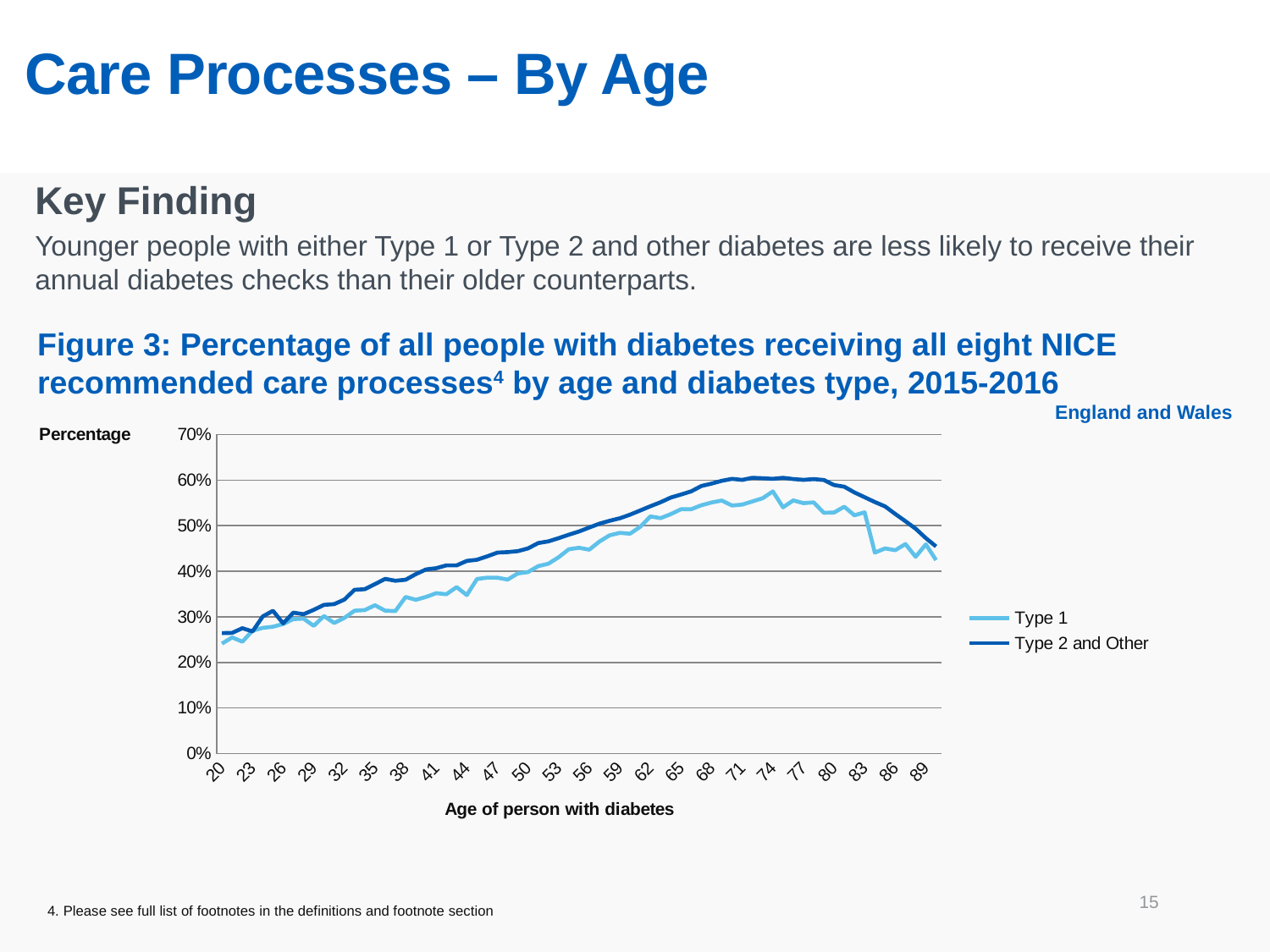
How many series does the legend list? 2 Is the Type 2 and Other value at age 89 greater or less than 50%? less At age 83, which series has the higher value, Type 1 or Type 2 and Other? Type 2 and Other At age 50, which series has the higher value, Type 1 or Type 2 and Other? Type 2 and Other Is the Type 1 value at age 86 greater or less than 50%? less Which series reaches the higher peak value? Type 2 and Other What is the label of the x axis? Age of person with diabetes Is the Type 1 value at age 20 greater or less than 30%? less What kind of chart is shown in Figure 3? line chart Do the values for Type 1 rise or fall between age 80 and age 89? fall Do the values for Type 2 and Other rise or fall between age 20 and age 70? rise